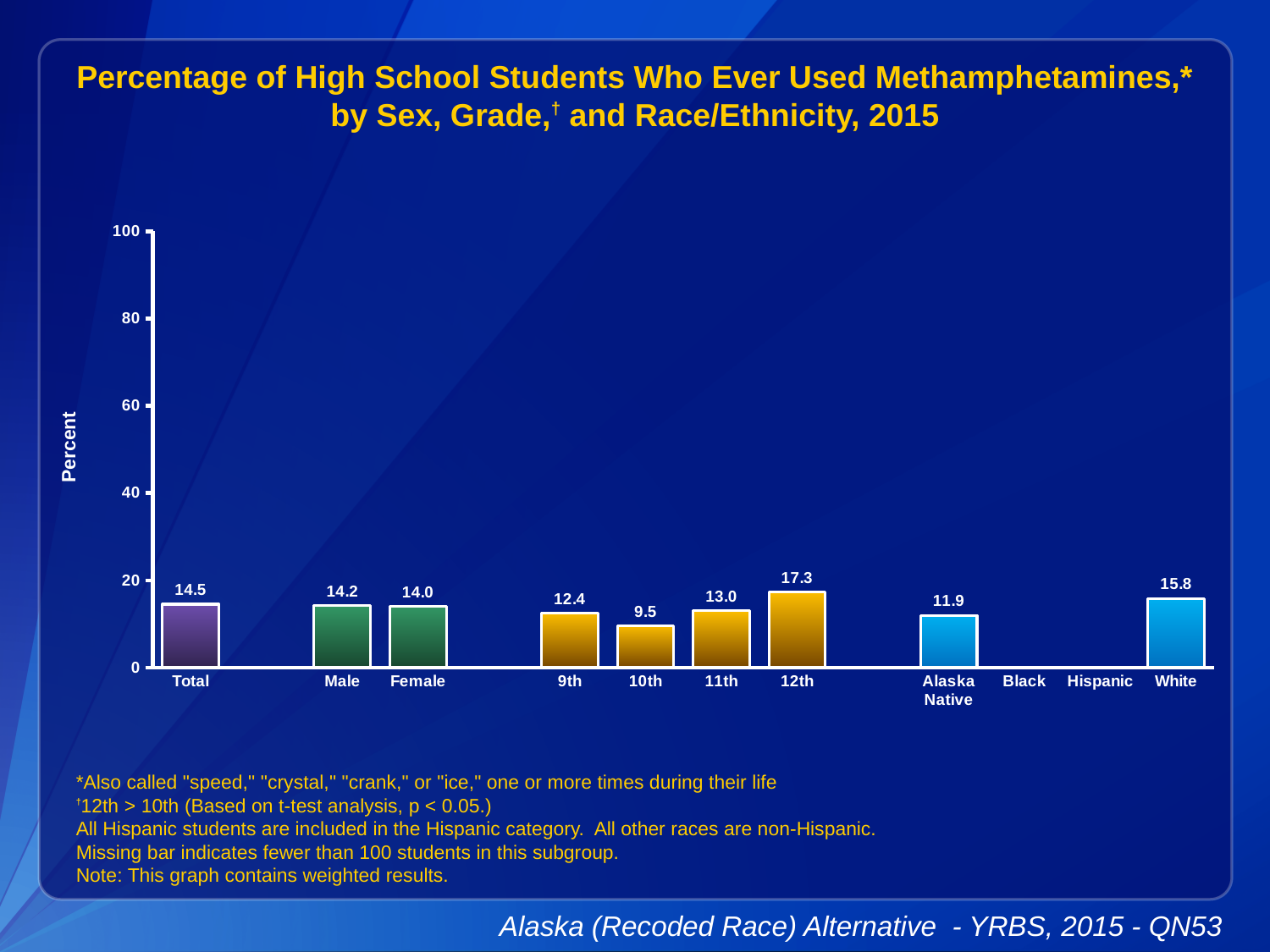
How many categories have a plotted bar? 9 What is the difference between the values for Male and Female? 0.2 What is the value for Alaska Native? 11.9 What is the value for Total? 14.5 Which category with a plotted bar has the lowest value? 10th What kind of chart is shown? bar chart Which is larger, the value for White or the value for Alaska Native? White Which category has the highest value? 12th What is the label on the y axis? Percent Is the value for 12th greater or less than 20? less What is the difference between the values for 12th and 10th? 7.8 What is the value for 12th grade? 17.3